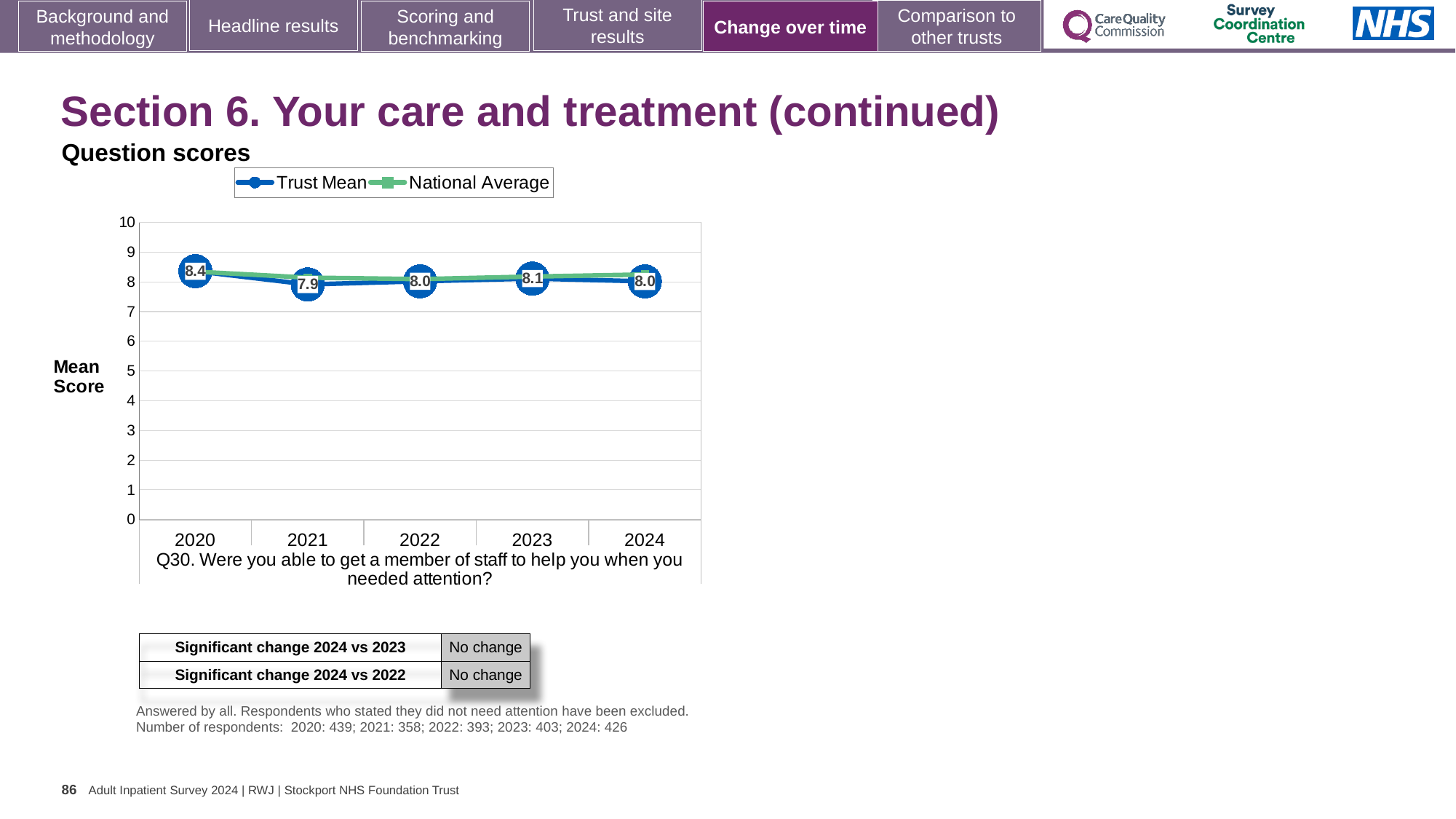
Is the National Average value for 2022 greater or less than 7? greater What is the Trust Mean score for 2023? 8.1 What is the Trust Mean score for 2021? 7.9 Is the Trust Mean score higher in 2023 or in 2021? 2023 What is the Trust Mean score for 2020? 8.4 In which year is the Trust Mean score lowest? 2021 What is the difference between the Trust Mean score in 2020 and in 2021? 0.5 What is the Trust Mean score for 2024? 8.0 In which year is the Trust Mean score highest? 2020 What type of chart is shown? Line chart How many years are plotted on the x axis? 5 How many series does the legend list? 2